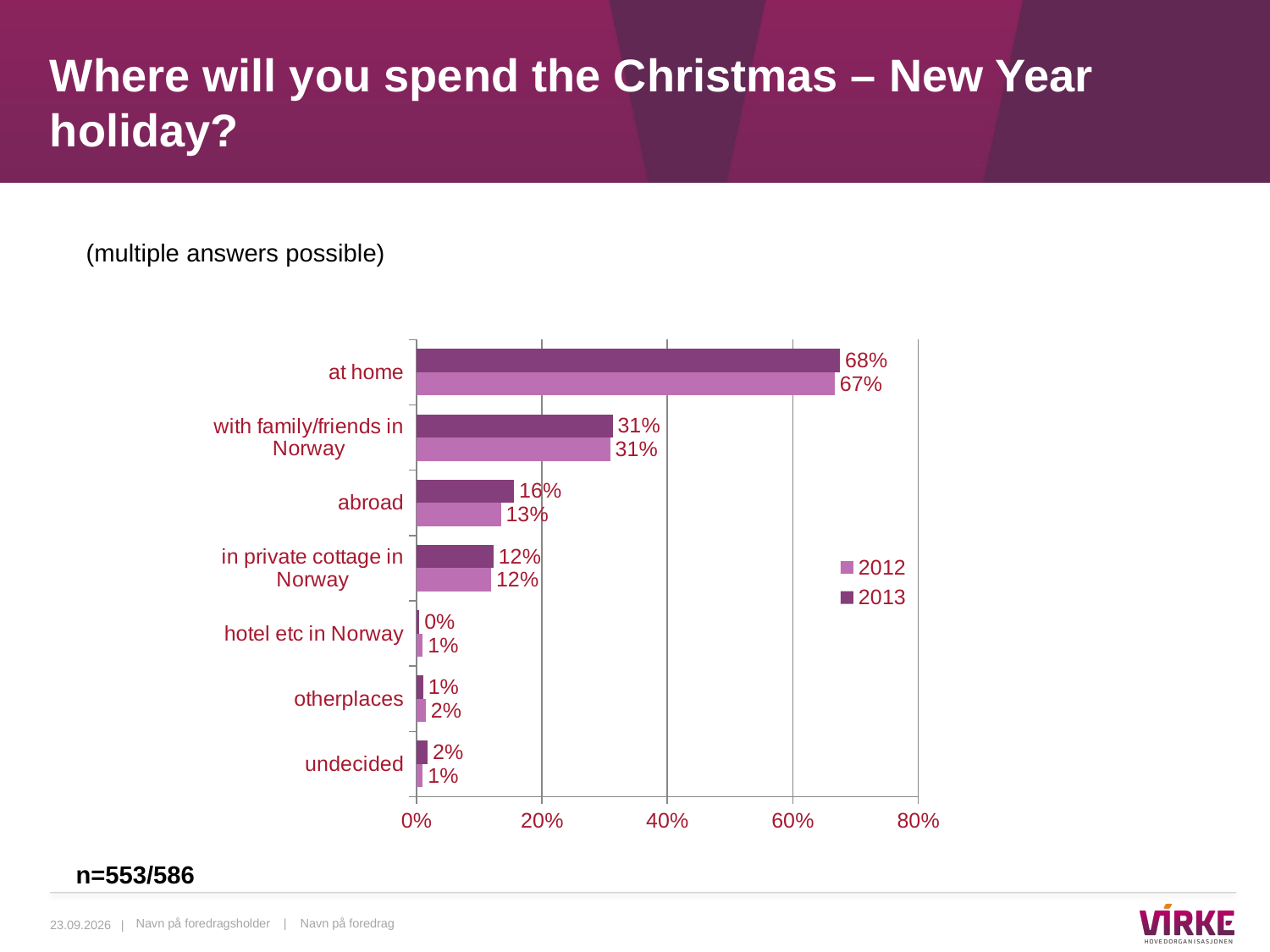
What is the 2012 value for 'in private cottage in Norway'? 12% How many categories are shown on the chart? 7 What percentage of respondents said they will spend the holiday at home in 2013? 68% Which category has the highest value in 2013? at home What is the 2013 value for 'with family/friends in Norway'? 31% What is the 2012 value for 'abroad'? 13% Which years are listed in the chart legend? 2012 and 2013 Which category has the lowest value in 2013? hotel etc in Norway Which is larger for 'undecided': the 2012 value or the 2013 value? 2013 How many series does the legend list? 2 What is the difference between the 2013 and 2012 values for 'abroad'? 3% What kind of chart is shown on the slide? bar chart